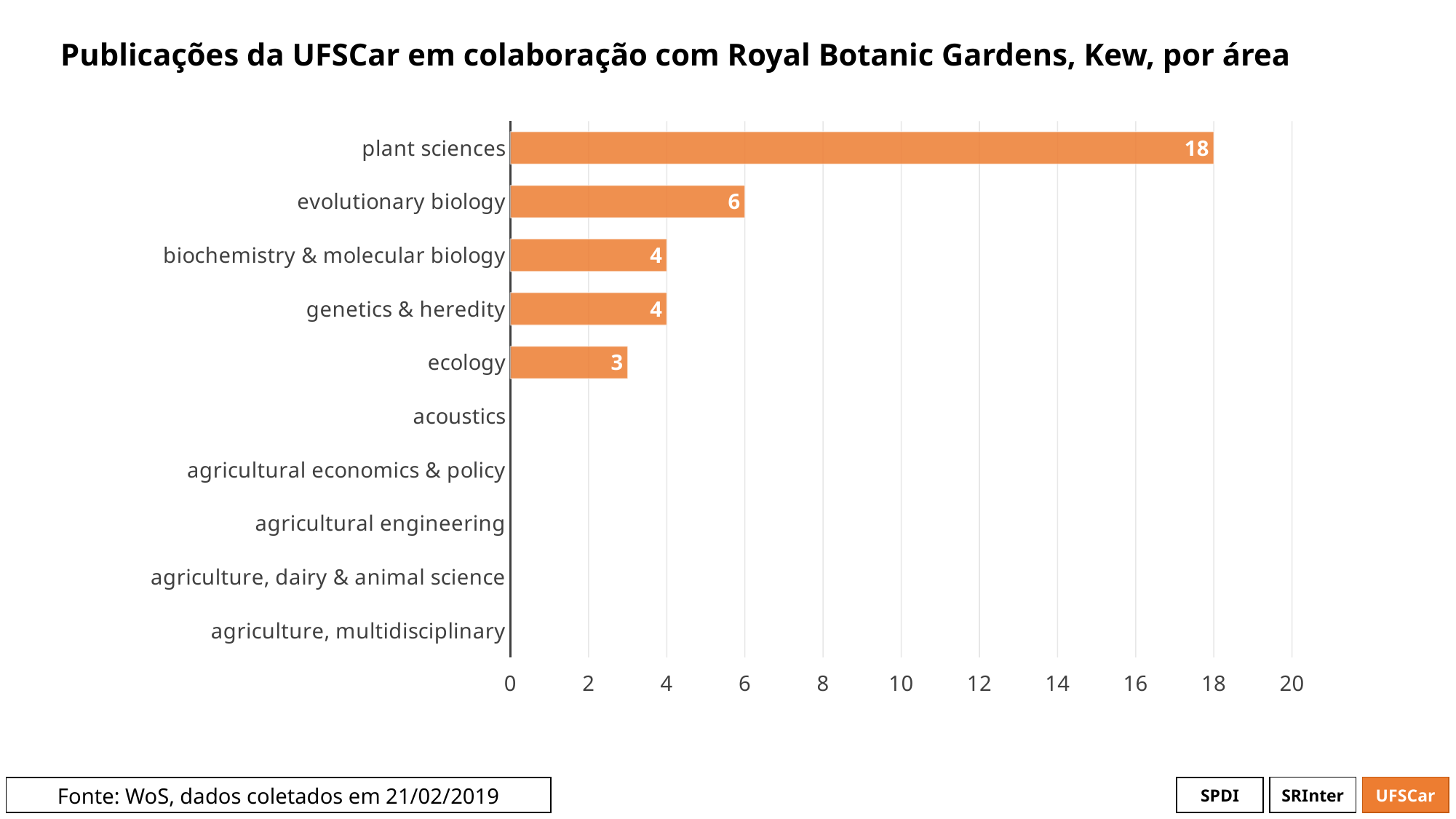
Which category has the highest value? plant sciences What is the title of the chart? Publicações da UFSCar em colaboração com Royal Botanic Gardens, Kew, por área Is the value for plant sciences greater or less than 10? greater What is the value for plant sciences? 18 What is the difference between plant sciences and evolutionary biology? 12 What is the value for ecology? 3 Which is larger, evolutionary biology or ecology? evolutionary biology How many categories are listed on the vertical axis? 10 What is the difference between biochemistry & molecular biology and ecology? 1 What is the value for genetics & heredity? 4 What kind of chart is shown? bar chart What is the value for evolutionary biology? 6